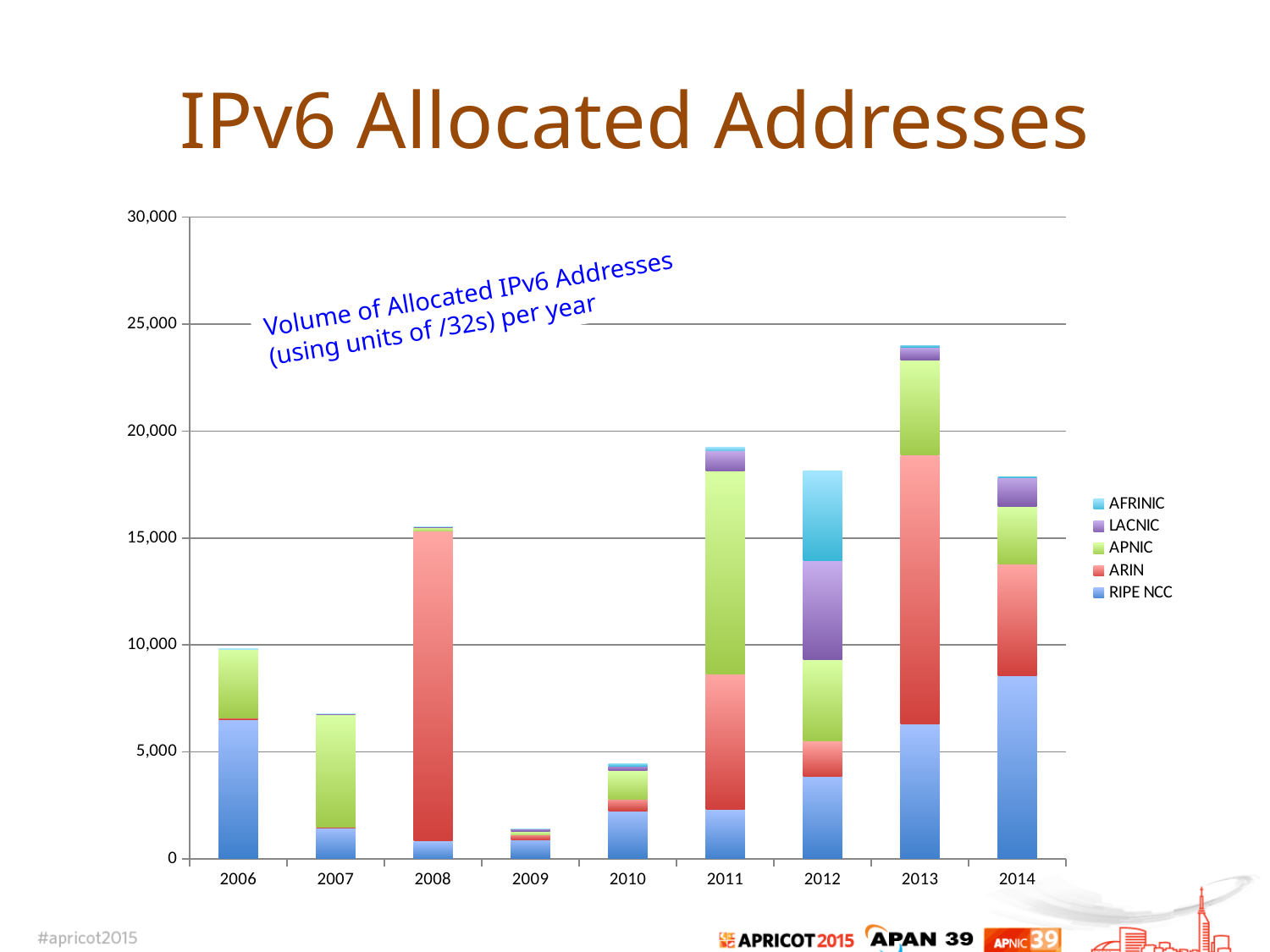
Does the total volume rise or fall from 2013 to 2014? fall Which year has the larger total, 2007 or 2008? 2008 Which series makes up most of the 2008 bar? ARIN Is the total for 2012 greater or less than 20,000? less What kind of chart is shown on the slide? stacked bar chart How many series does the chart's legend list? 5 How many years are shown along the x axis of the chart? 9 Is the total for 2010 greater or less than 5,000? less Which series is shown at the bottom of each stacked bar? RIPE NCC Is the total for 2013 greater or less than 20,000? greater Which year has the lowest total volume of allocated IPv6 addresses? 2009 Which year has the highest total volume of allocated IPv6 addresses? 2013